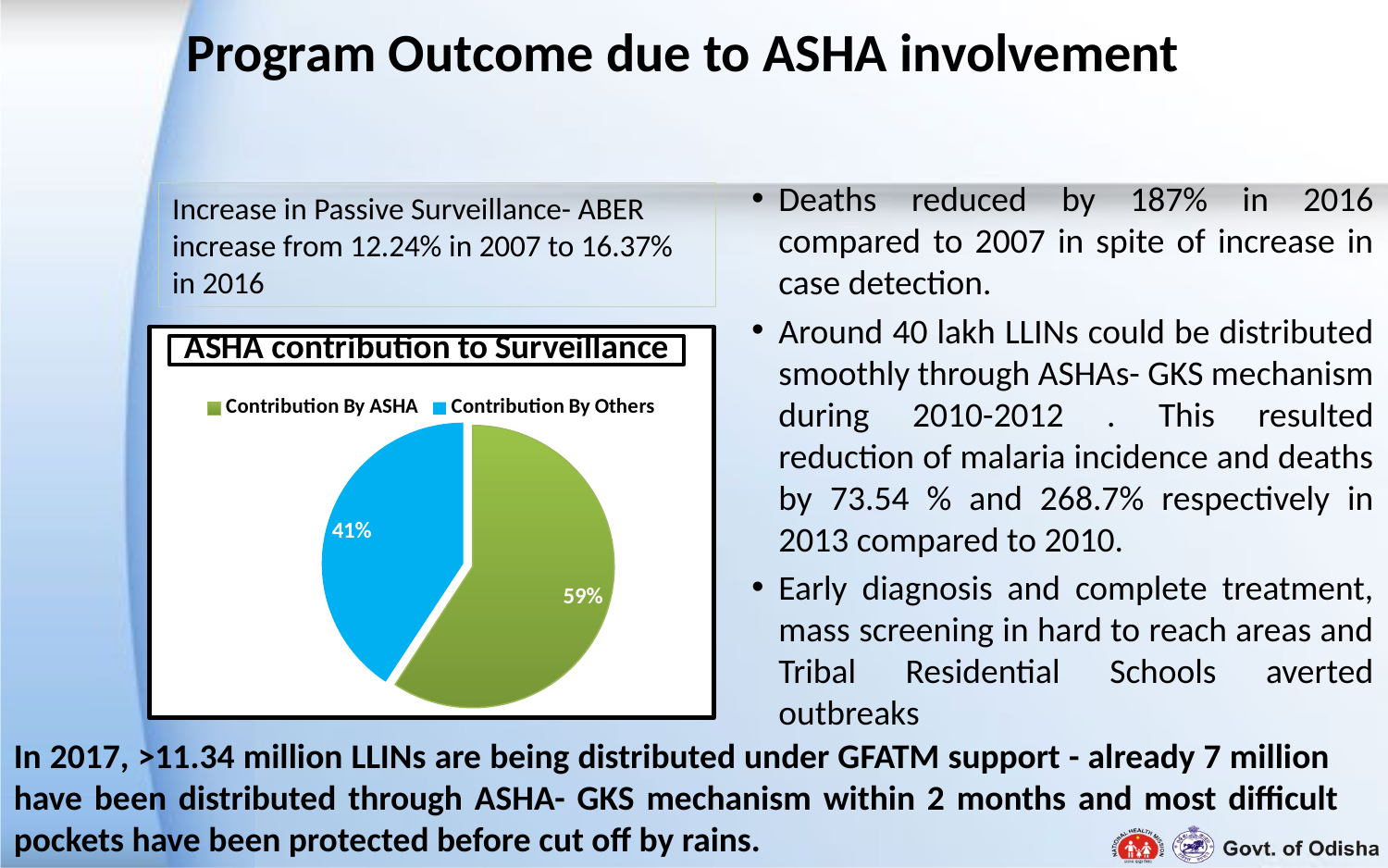
What percentage of the pie is Contribution By Others? 41% What is the difference in percentage points between Contribution By ASHA and Contribution By Others? 18 Which slice is the smallest in the pie chart? Contribution By Others How many slices does the pie chart have? 2 Which is larger, Contribution By ASHA or Contribution By Others? Contribution By ASHA What percentage of the pie is Contribution By ASHA? 59% How many entries does the legend list? 2 Which slice is the largest in the pie chart? Contribution By ASHA What is the total of the two slices shown in the pie chart? 100% What colour is the Contribution By Others slice? blue What type of chart is shown on the slide? pie chart What is the title of the chart? ASHA contribution to Surveillance